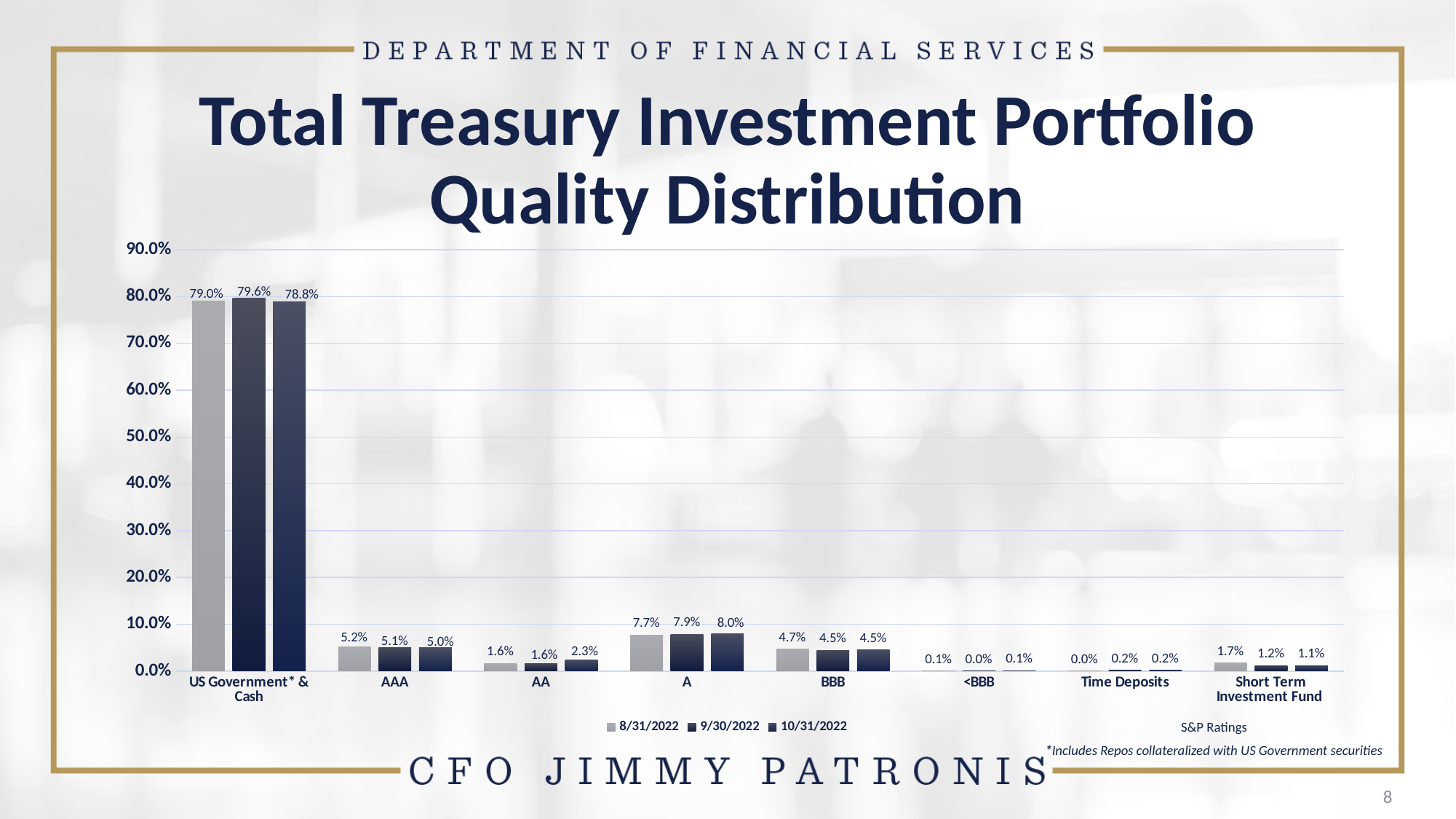
Which is larger for 8/31/2022: AAA or BBB? AAA How many categories are shown on the x axis? 8 What is the value for Short Term Investment Fund on 10/31/2022? 1.1% How many series does the legend list? 3 What is the value for A on 9/30/2022? 7.9% What is the title of the chart? Total Treasury Investment Portfolio Quality Distribution Which category has the highest value for 9/30/2022? US Government* & Cash What is the value for US Government* & Cash on 10/31/2022? 78.8% What is the difference between the 10/31/2022 values for A and BBB? 3.5% What kind of chart is shown on the slide? bar chart What is the value for AA on 8/31/2022? 1.6% Is the value for US Government* & Cash on 8/31/2022 greater or less than 70.0%? greater